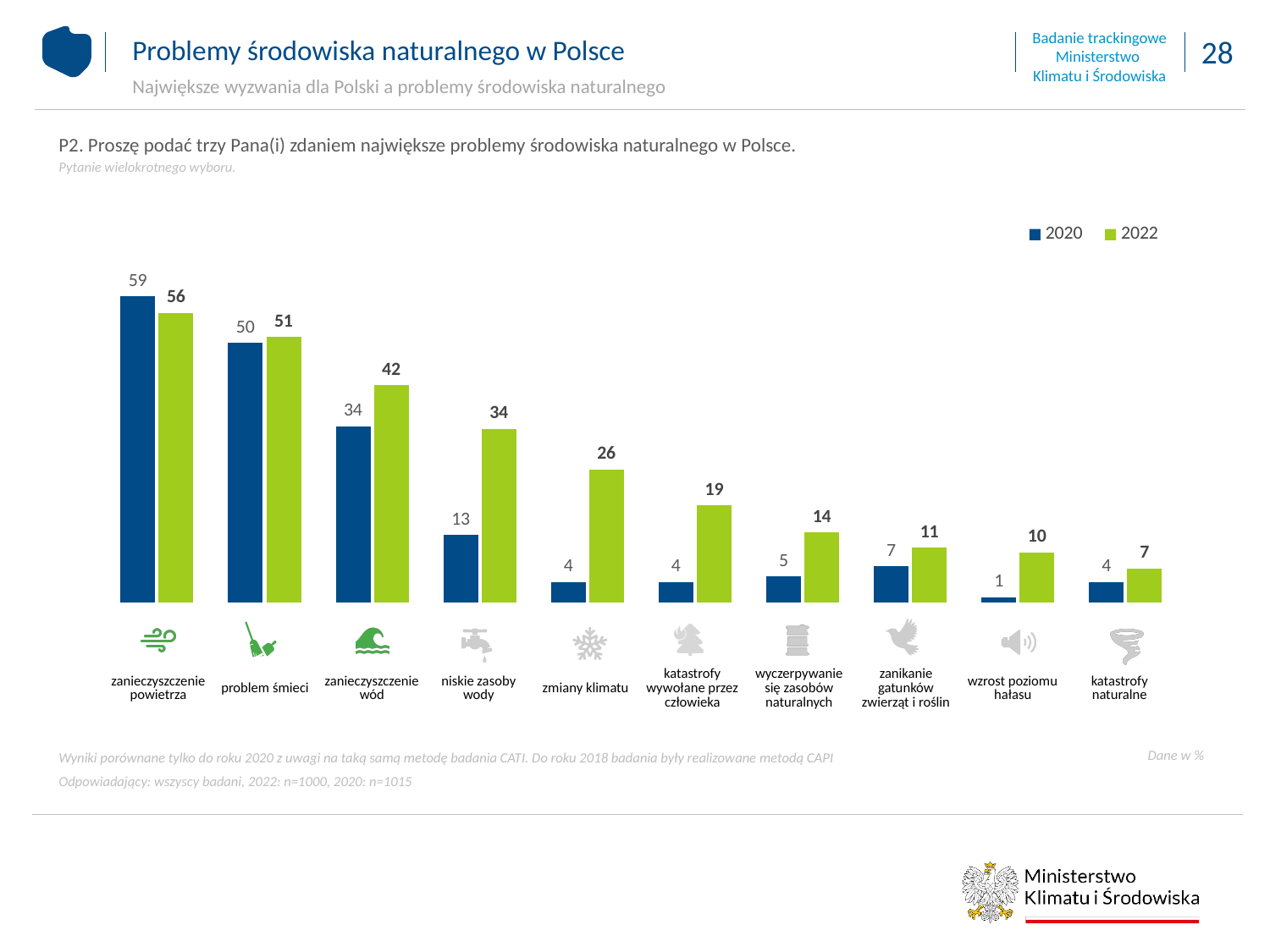
Which category has the lowest 2020 value? wzrost poziomu hałasu Which year does the green series represent? 2022 What is the difference between the 2022 and 2020 values for zmiany klimatu? 22 What kind of chart is shown on the slide? bar chart Which category has the highest 2020 value? zanieczyszczenie powietrza Which is larger for problem śmieci: the 2020 value or the 2022 value? 2022 How many series does the legend list? 2 What is the 2022 value for zmiany klimatu? 26 What is the 2022 value for zanieczyszczenie powietrza? 56 What is the 2020 value for niskie zasoby wody? 13 What is the difference between the 2020 and 2022 values for zanieczyszczenie powietrza? 3 How many categories are shown on the chart? 10